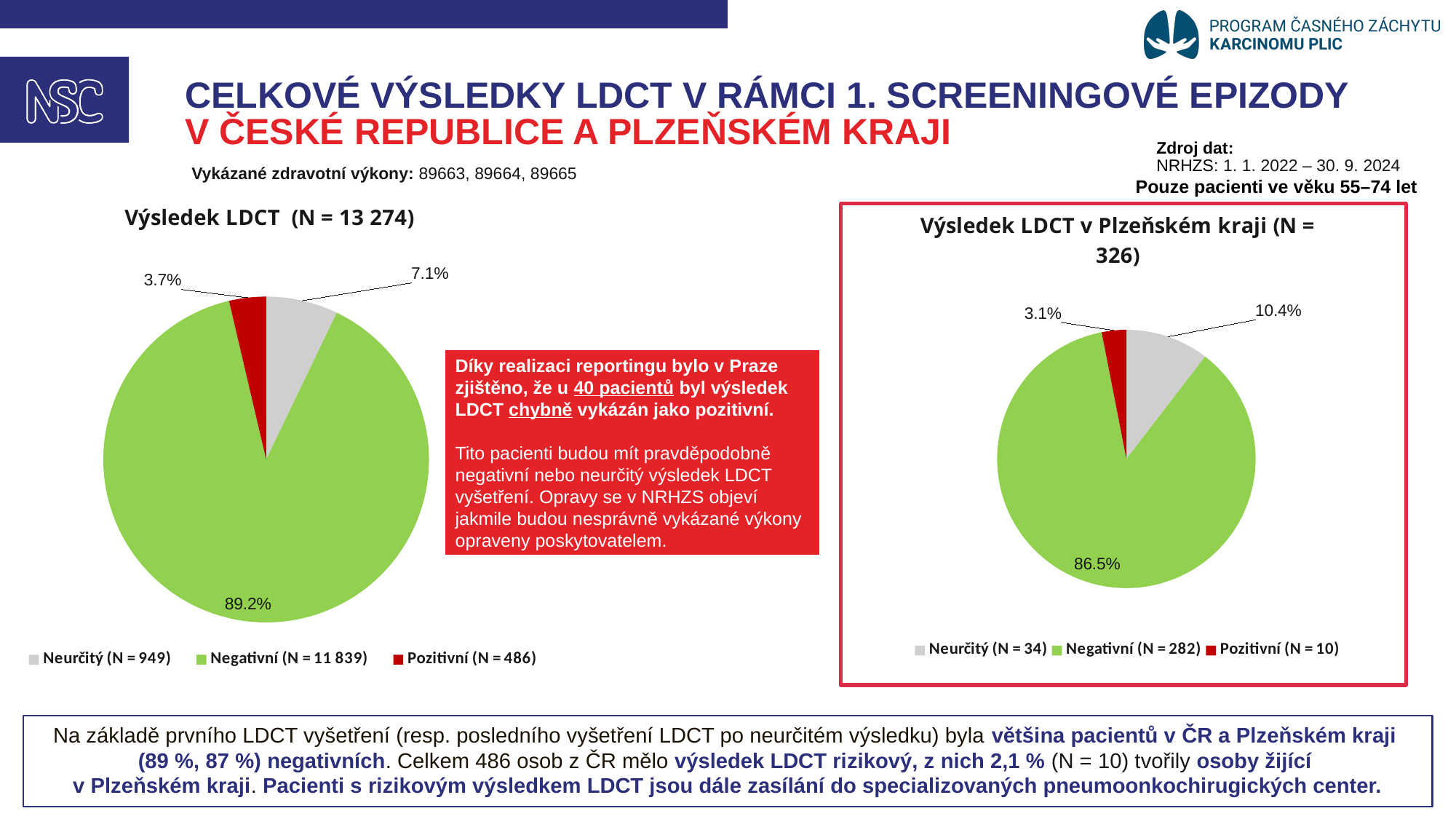
In the right chart "Výsledek LDCT v Plzeňském kraji (N = 326)", what is the difference between the Neurčitý and Pozitivní shares? 7.3% In the right chart "Výsledek LDCT v Plzeňském kraji (N = 326)", what N value does the legend give for Pozitivní? N = 10 In the right chart "Výsledek LDCT v Plzeňském kraji (N = 326)", which category has the largest slice? Negativní In the right chart "Výsledek LDCT v Plzeňském kraji (N = 326)", what share of the pie is Negativní? 86.5% In the left chart "Výsledek LDCT (N = 13 274)", what share of the pie is Pozitivní? 3.7% What kind of chart is the left chart titled "Výsledek LDCT (N = 13 274)"? pie chart Which is larger: the Neurčitý share in the left chart "Výsledek LDCT (N = 13 274)" or the Neurčitý share in the right chart "Výsledek LDCT v Plzeňském kraji (N = 326)"? the right chart (10.4%) In the left chart "Výsledek LDCT (N = 13 274)", what share of the pie is Negativní? 89.2% In the left chart "Výsledek LDCT (N = 13 274)", which category has the smallest slice? Pozitivní In the left chart "Výsledek LDCT (N = 13 274)", how many slices does the pie have? 3